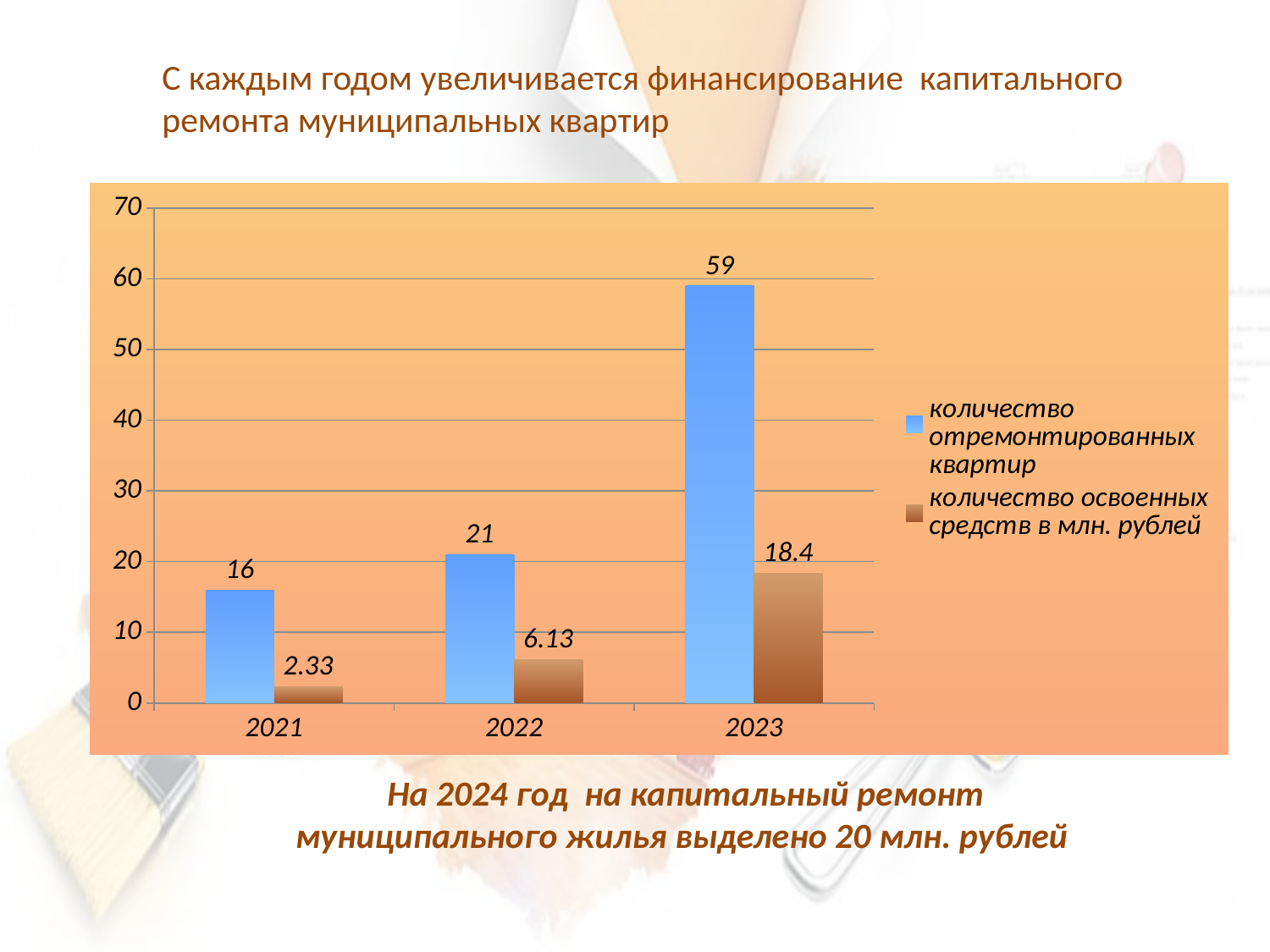
Which is larger: the number of repaired apartments in 2021 or in 2022? 2022 Which year has the highest number of repaired apartments? 2023 What is the difference in funds used between 2023 and 2021? 16.07 What is the difference in the number of repaired apartments between 2023 and 2022? 38 What is the number of repaired apartments (количество отремонтированных квартир) in 2023? 59 What is the amount of funds used (количество освоенных средств в млн. рублей) in 2022? 6.13 Which year has the lowest amount of funds used? 2021 How many series does the legend list? 2 What kind of chart is shown on the slide? bar chart What is the amount of funds used in 2021? 2.33 Is the number of repaired apartments in 2023 greater or less than 50? greater How many years are shown on the x axis? 3